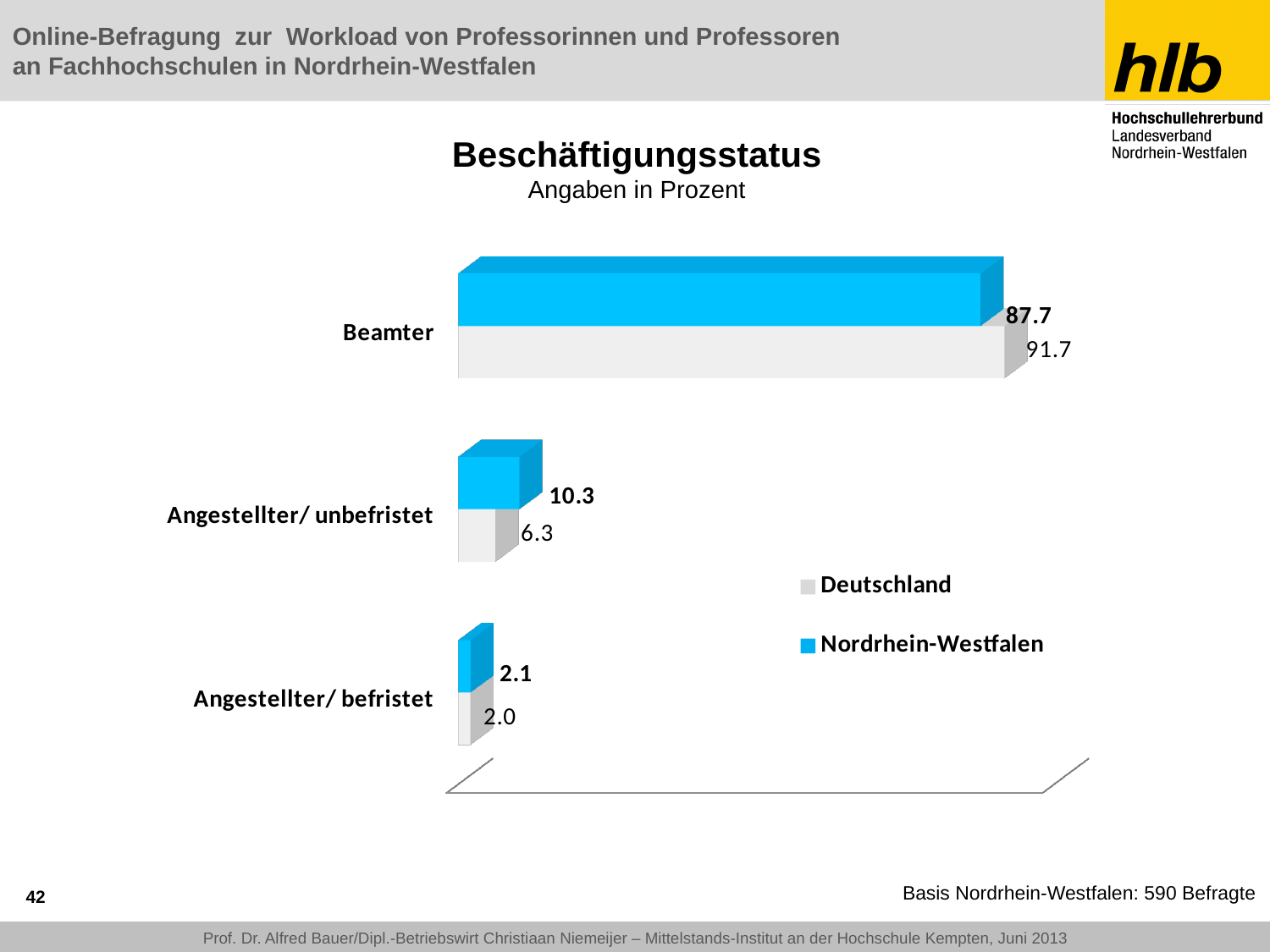
What type of chart is shown on the slide? Bar chart What is the value for Deutschland in the Beamter category? 91.7 Which is larger for Angestellter/ unbefristet: Deutschland or Nordrhein-Westfalen? Nordrhein-Westfalen How many categories are shown in the chart? 3 What is the value for Nordrhein-Westfalen in the Beamter category? 87.7 Which category has the lowest value for Deutschland? Angestellter/ befristet What is the value for Deutschland in the Angestellter/ befristet category? 2.0 What is the difference between the Deutschland and Nordrhein-Westfalen values for Beamter? 4.0 How many series does the legend list? 2 Which category has the highest value for Nordrhein-Westfalen? Beamter What is the value for Nordrhein-Westfalen in the Angestellter/ unbefristet category? 10.3 What is the difference between the Nordrhein-Westfalen and Deutschland values for Angestellter/ unbefristet? 4.0